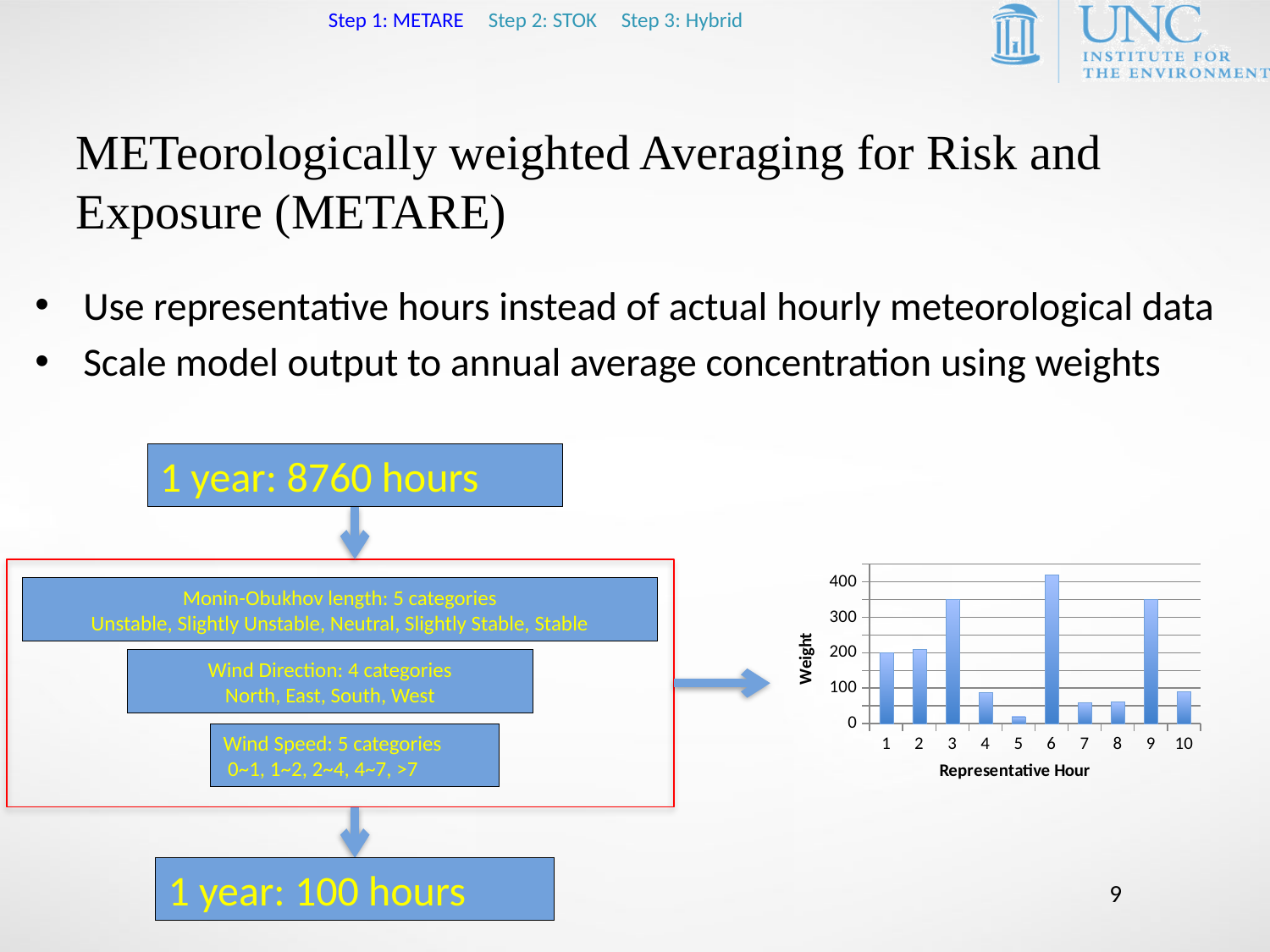
Is the weight for representative hour 6 greater or less than 400? greater Is the weight for representative hour 5 greater or less than 100? less Is the weight for representative hour 3 greater or less than 300? greater Which representative hour has the lowest weight in the chart? 5 Which representative hour has the highest weight in the chart? 6 What is the title of the y axis of the chart? Weight Which has the larger weight, representative hour 6 or representative hour 1? 6 What kind of chart is shown on the slide? bar chart How many representative hours are plotted on the x axis of the chart? 10 Which has the larger weight, representative hour 3 or representative hour 4? 3